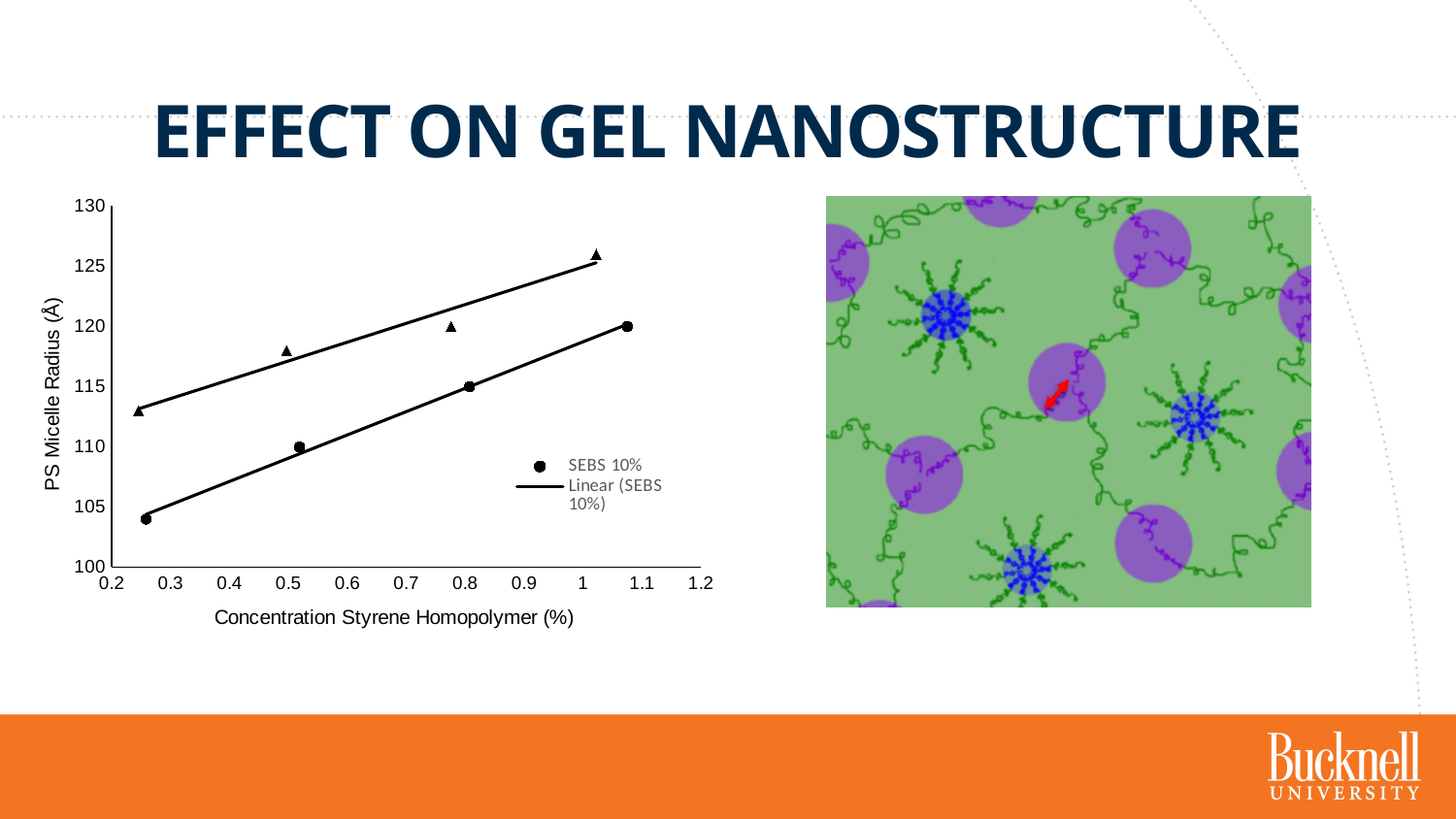
What kind of chart is shown on the left of the slide? scatter chart At a concentration of about 0.5%, which series has the larger PS micelle radius: the circle series or the triangle series? the triangle series What is the label of the y axis of the chart? PS Micelle Radius (Å) How many circular SEBS 10% data points are plotted on the chart? 4 Which SEBS 10% data point has the highest PS micelle radius: the one at the lowest concentration or the one at the highest concentration? the one at the highest concentration What is the label of the x axis of the chart? Concentration Styrene Homopolymer (%) What is the maximum value shown on the y axis of the chart? 130 Do the SEBS 10% values rise or fall as the concentration of styrene homopolymer increases? rise How many entries does the chart's legend list? 2 Is the highest triangle data point on the chart greater or less than 125? greater Is the SEBS 10% value at the lowest plotted concentration (about 0.25%) greater or less than 105? less Is the SEBS 10% value at the highest plotted concentration (about 1.1%) greater or less than 115? greater